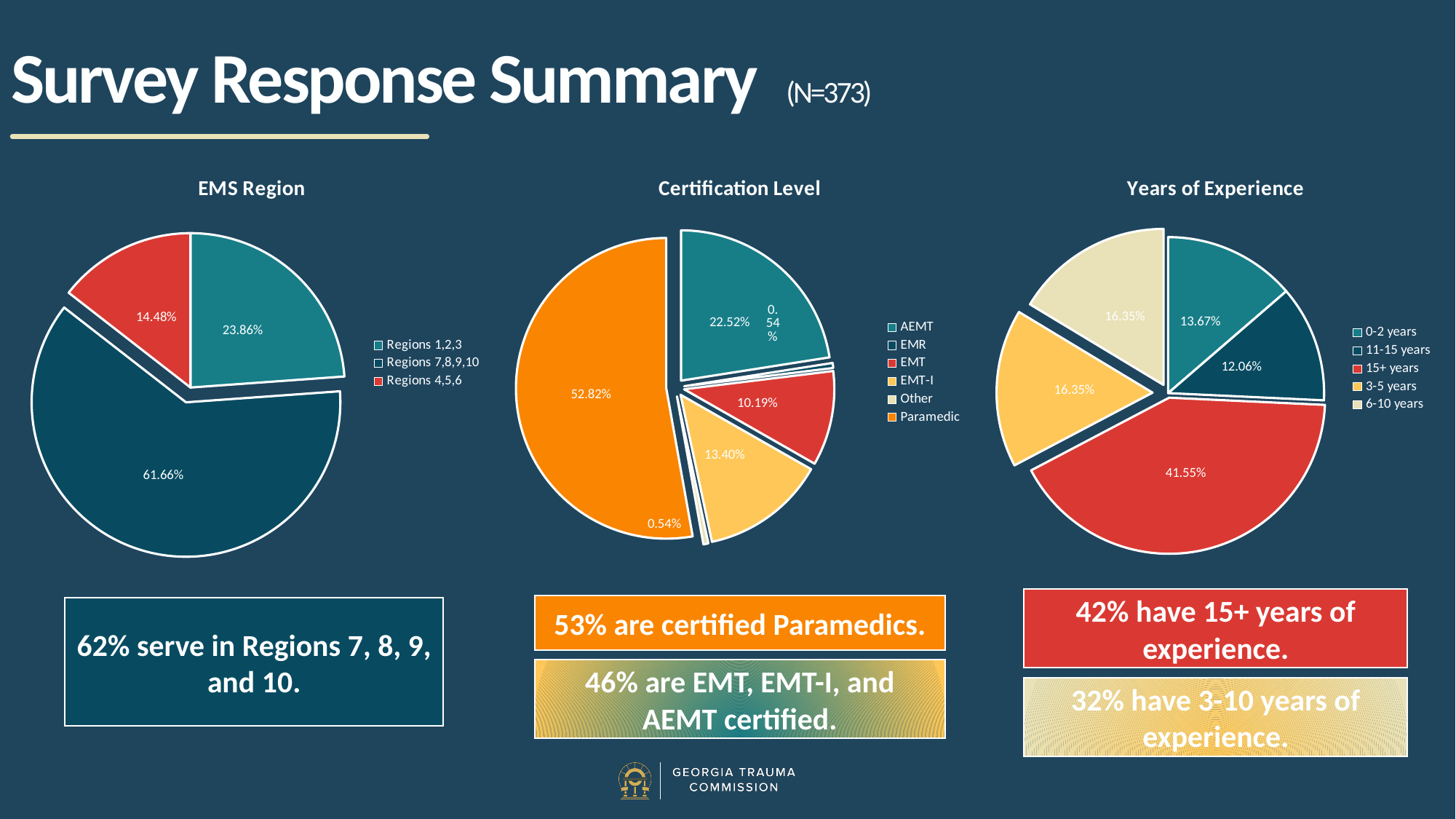
How many certification levels does the legend of the Certification Level chart list? 6 In the EMS Region chart, what is the difference between the Regions 1,2,3 slice and the Regions 4,5,6 slice? 9.38% In the Certification Level chart, what percentage of respondents are Paramedics? 52.82% In the Certification Level chart, what percentage of respondents are EMT-I certified? 13.40% In the EMS Region chart, which region group has the smallest slice? Regions 4,5,6 In the Years of Experience chart, what is the difference between the 0-2 years slice and the 11-15 years slice? 1.61% In the EMS Region chart, what share of respondents serve in Regions 7,8,9,10? 61.66% In the Certification Level chart, which is larger, the AEMT slice or the EMT slice? AEMT In the Years of Experience chart, what share of respondents have 15+ years of experience? 41.55% In the Years of Experience chart, which category has the smallest slice? 11-15 years What type of chart is used for the Years of Experience data? Pie chart In the Certification Level chart, which certification level has the largest slice? Paramedic